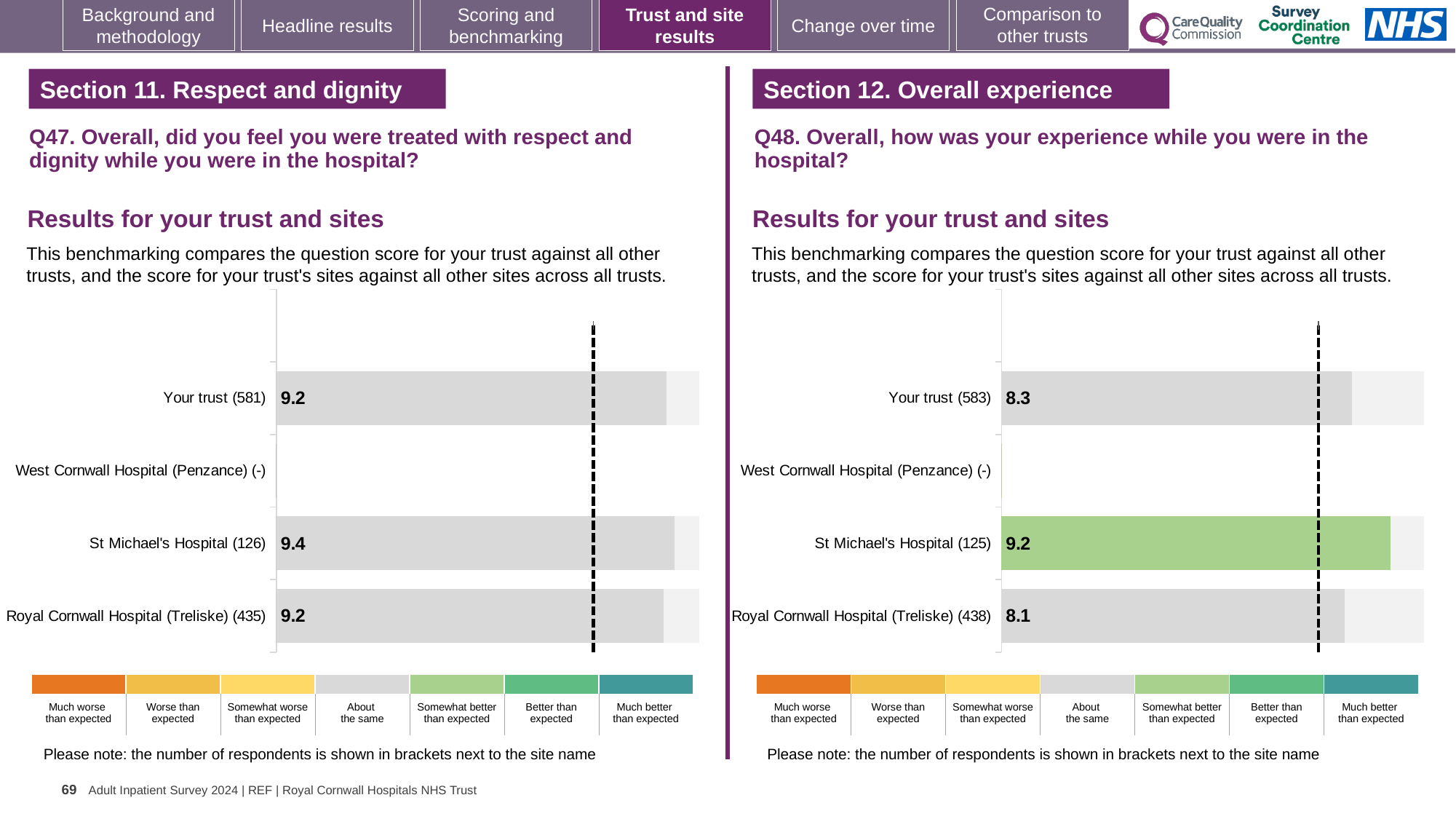
On the Q47 chart (left), what is the score for Royal Cornwall Hospital (Treliske)? 9.2 On the Q47 chart (left), which has the larger score, St Michael's Hospital or Your trust? St Michael's Hospital On the Q48 chart (right), which site has the lowest score among those with a score shown? Royal Cornwall Hospital (Treliske) On the Q48 chart (right), what is the score for Royal Cornwall Hospital (Treliske)? 8.1 On the Q48 chart (right), what is the score for Your trust? 8.3 On the Q48 chart (right), which site has the highest score? St Michael's Hospital On the Q47 chart (left), what is the score for St Michael's Hospital? 9.4 What kind of chart is used on the Q47 chart (left)? Bar chart On the Q48 chart (right), what is the score for St Michael's Hospital? 9.2 On the Q48 chart (right), what is the difference between the scores for St Michael's Hospital and Royal Cornwall Hospital (Treliske)? 1.1 On the Q47 chart (left), what is the score for Your trust? 9.2 On the Q48 chart (right), how many respondents are shown in brackets for Your trust? 583